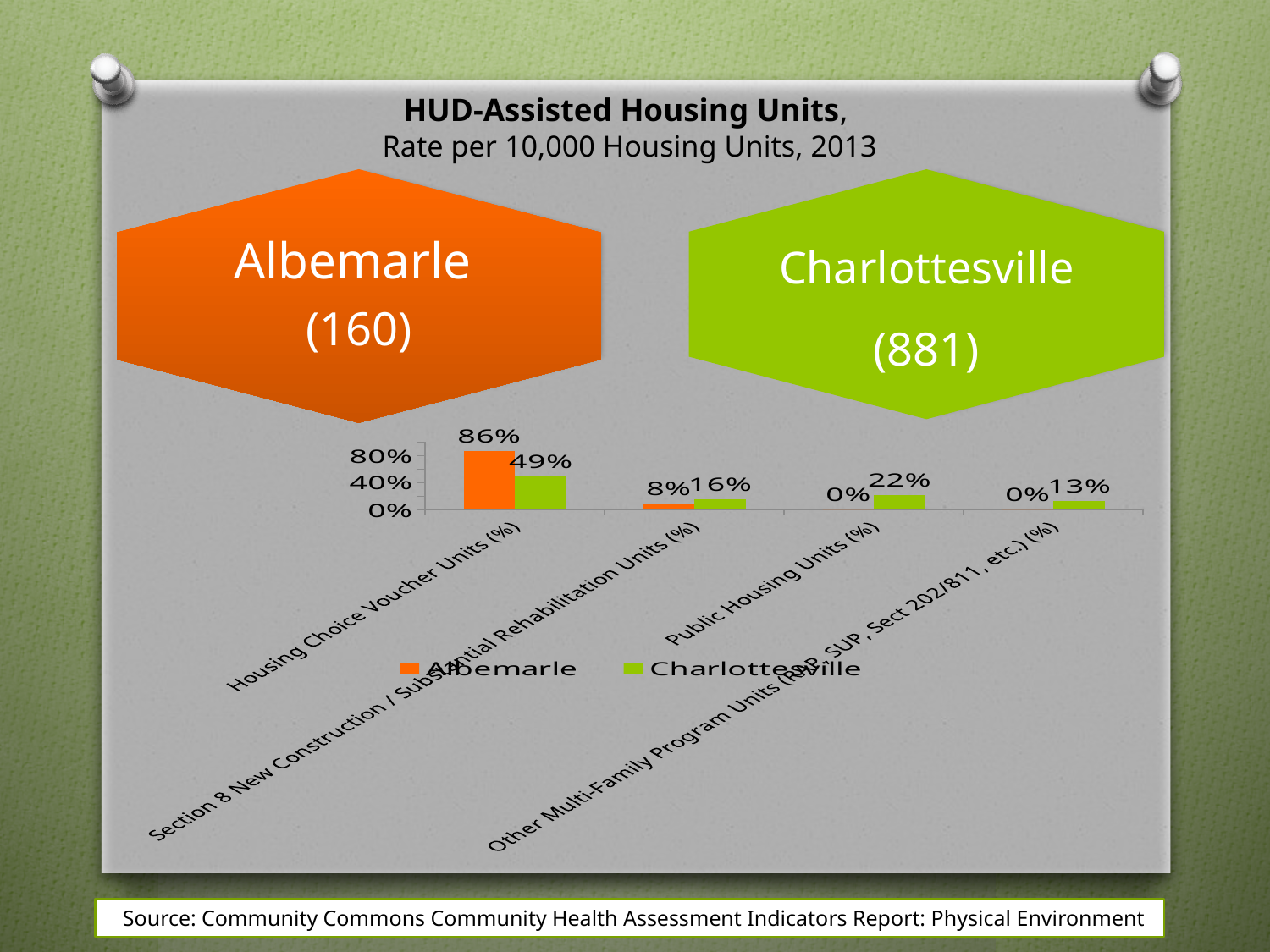
What kind of chart is shown on the slide? Bar chart Which category has the highest value for Charlottesville? Housing Choice Voucher Units (%) What is the value for Charlottesville for Public Housing Units (%)? 22% What is the value for Charlottesville for Other Multi-Family Program Units (RAP, SUP, Sect 202/811, etc.) (%)? 13% What is the value for Albemarle for Public Housing Units (%)? 0% What is the value for Albemarle for Housing Choice Voucher Units (%)? 86% What is the difference between the Charlottesville and Albemarle values for Section 8 New Construction / Substantial Rehabilitation Units (%)? 8% How many series does the chart legend list? 2 What is the difference between the Albemarle and Charlottesville values for Housing Choice Voucher Units (%)? 37% For Section 8 New Construction / Substantial Rehabilitation Units (%), which is larger, Albemarle or Charlottesville? Charlottesville What is the value for Charlottesville for Housing Choice Voucher Units (%)? 49% How many categories are shown on the x axis of the chart? 4